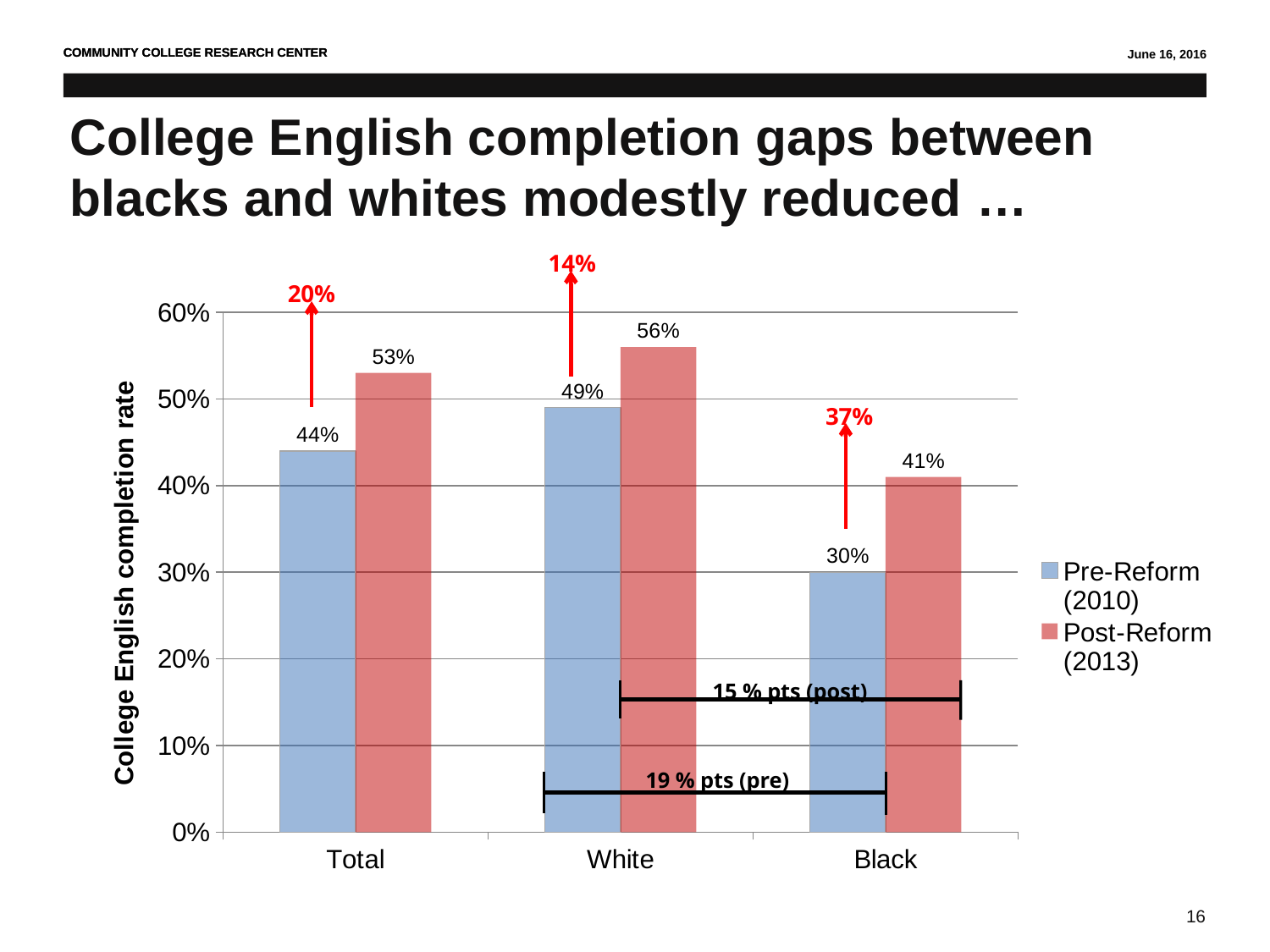
What is the difference between the Post-Reform (2013) and Pre-Reform (2010) completion rates for Black students? 11% How many series does the legend list? 2 What is the difference between the White and Black Pre-Reform (2010) completion rates? 19% What kind of chart is shown on the slide? Bar chart What is the Post-Reform (2013) College English completion rate for White students? 56% What is the Pre-Reform (2010) College English completion rate for Black students? 30% What is the Post-Reform (2013) College English completion rate for the Total group? 53% What is the label of the y axis? College English completion rate How many categories are shown on the x axis? 3 Which category has the highest Post-Reform (2013) completion rate? White Which category has the lowest Pre-Reform (2010) completion rate? Black Which is larger: the Pre-Reform (2010) rate for White students or the Post-Reform (2013) rate for Black students? Pre-Reform (2010) rate for White students